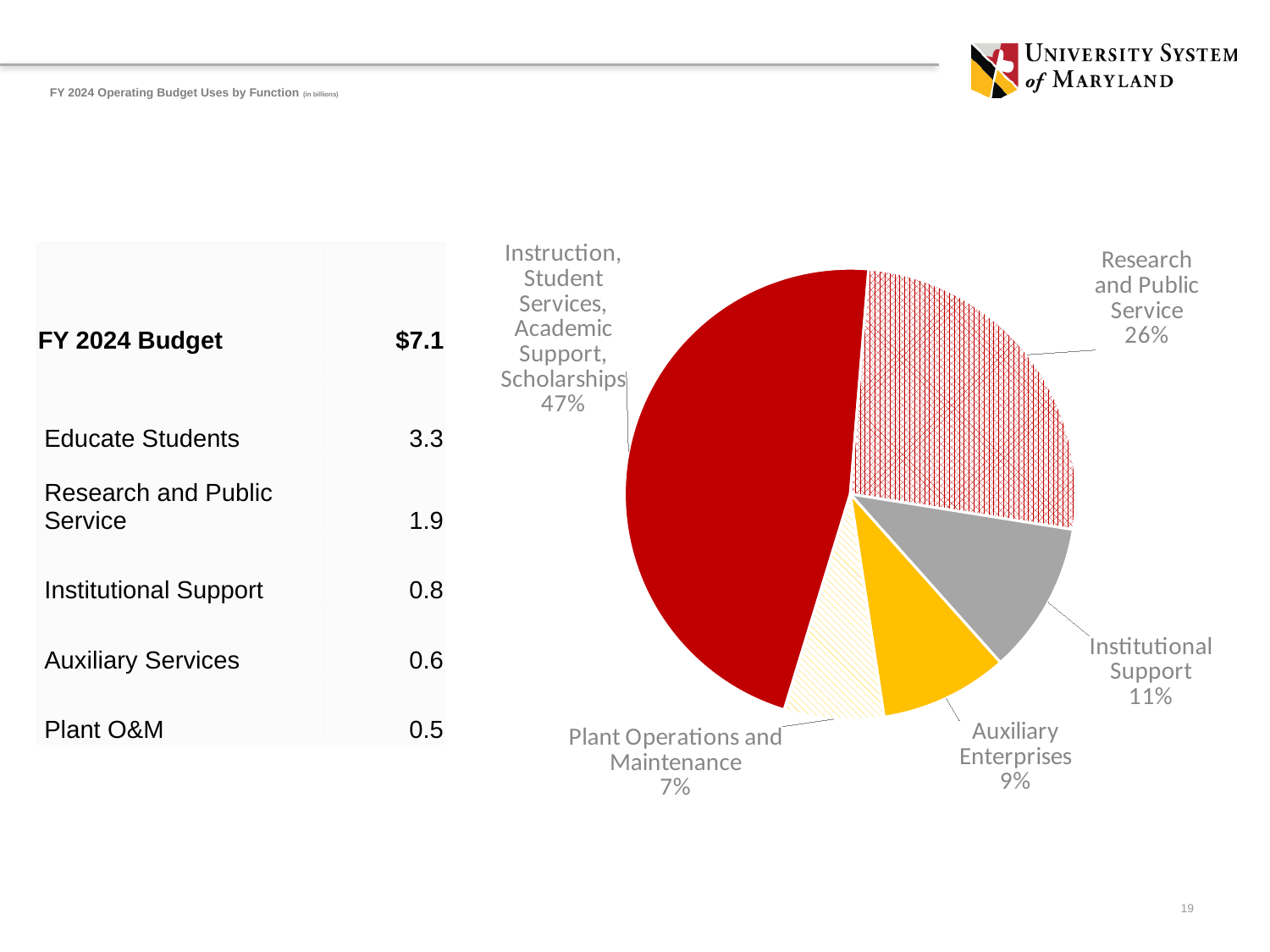
How many slices does the pie chart have? 5 What is the title of the chart on the slide? FY 2024 Operating Budget Uses by Function (in billions) What share of the pie does Research and Public Service represent? 26% Which slice of the pie is the smallest? Plant Operations and Maintenance Which slice is larger, Auxiliary Enterprises or Plant Operations and Maintenance? Auxiliary Enterprises What share of the pie does Plant Operations and Maintenance represent? 7% What is the difference in percentage points between the Research and Public Service slice and the Institutional Support slice? 15 Which slice of the pie is the largest? Instruction, Student Services, Academic Support, Scholarships What share of the pie does the Instruction, Student Services, Academic Support, Scholarships slice represent? 47% What kind of chart is shown on the slide? pie chart